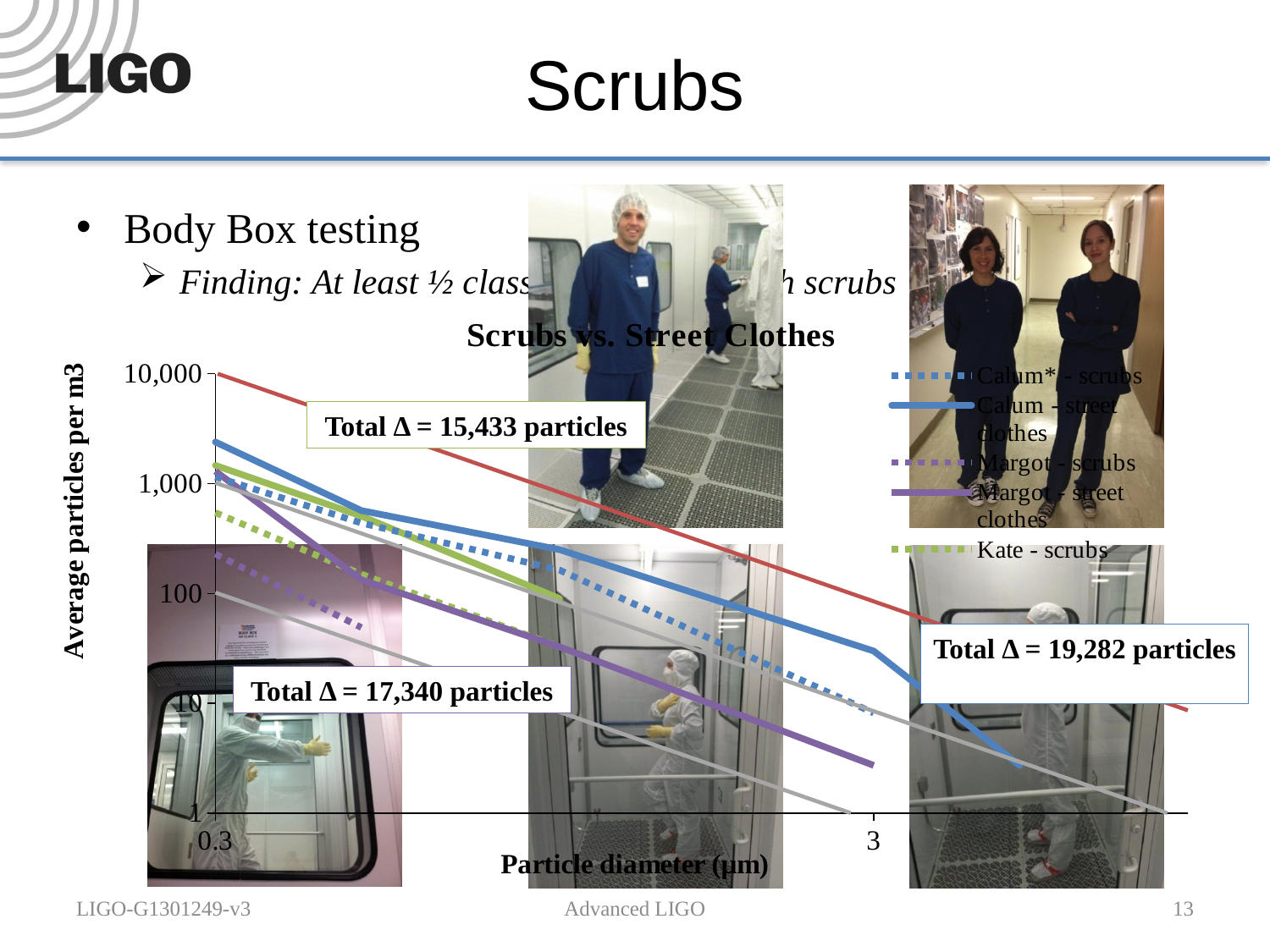
Do the plotted values rise or fall as particle diameter increases from 0.3 to 3 µm? fall Is the value for Kate - scrubs at 0.3 µm greater or less than 1,000? less Is the value for Calum - street clothes at 3 µm greater or less than 100? less What kind of chart is shown on the slide? line chart Is the value for Calum - street clothes at 0.3 µm greater or less than 1,000? greater At 0.3 µm, which is larger: Calum - street clothes or Kate - scrubs? Calum - street clothes What is the title of the chart? Scrubs vs. Street Clothes At 3 µm, which is larger: Calum - street clothes or Calum* - scrubs? Calum - street clothes What is the largest Total Δ value annotated on the chart? 19,282 particles